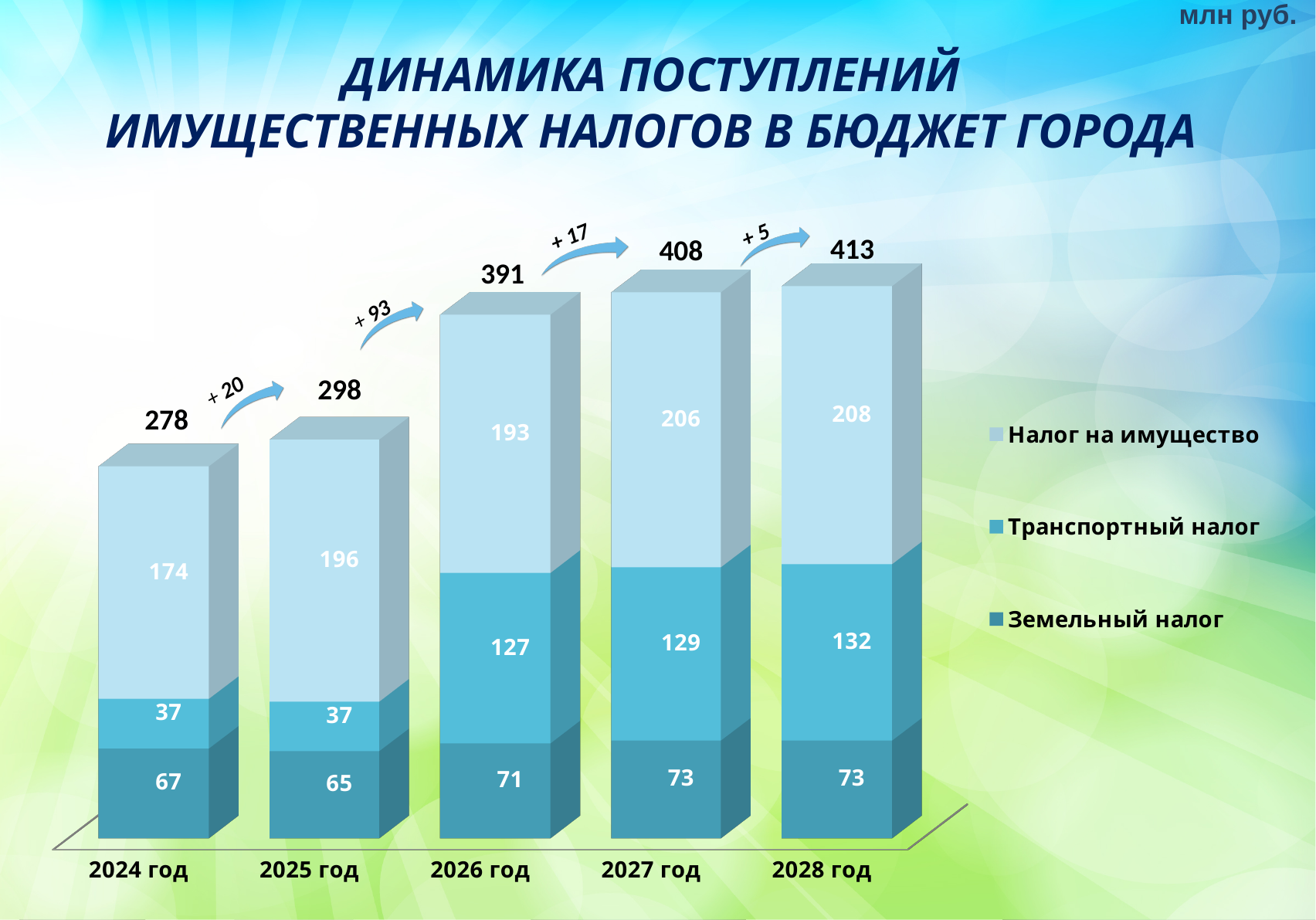
Which year has the lowest total? 2024 год Which year has the highest total? 2028 год What kind of chart is shown? stacked bar chart What is the value of Земельный налог for 2028 год? 73 What is the value of Налог на имущество for 2026 год? 193 How many years are shown on the x axis? 5 What is the value of Транспортный налог for 2024 год? 37 What is the total of the stacked bar for 2027 год? 408 What is the difference between the totals for 2026 год and 2025 год? 93 Do the totals rise or fall from 2024 год to 2028 год? rise How many series does the legend list? 3 Which is larger: Транспортный налог in 2026 год or Транспортный налог in 2025 год? Транспортный налог in 2026 год